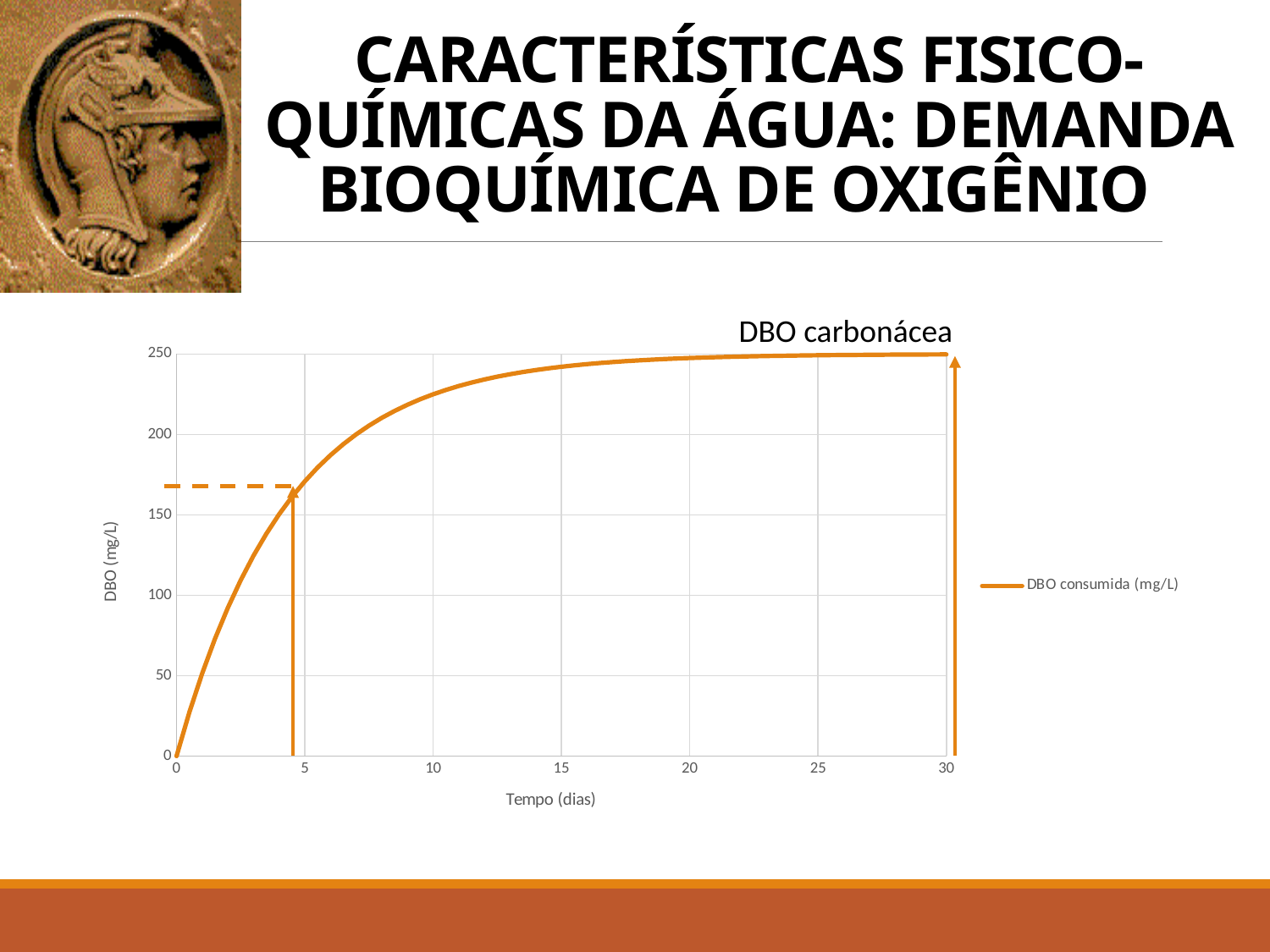
Is the value of DBO consumida at 3 dias greater or less than 100? greater What kind of chart is shown on the slide? line chart How many series does the chart legend list? 1 Does the DBO consumida value rise or fall as Tempo (dias) increases? rise Is the value of DBO consumida at 3 dias greater or less than 150? less What is the title of the chart? DBO carbonácea Is the value of DBO consumida at 20 dias greater or less than 200? greater Which is larger, the DBO consumida value at 5 dias or at 25 dias? 25 dias What is the name of the series shown in the legend? DBO consumida (mg/L)